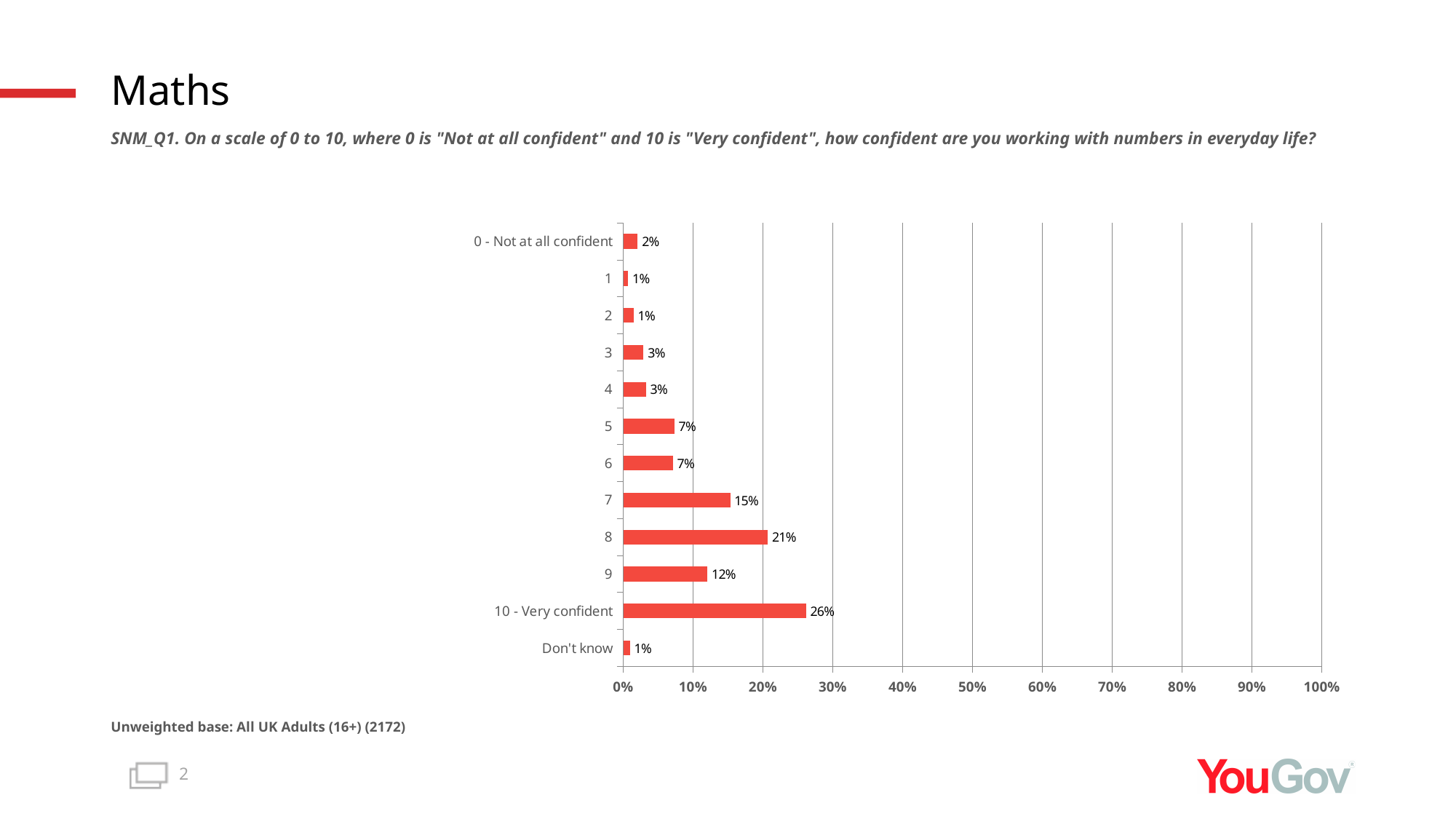
Which category has the highest percentage? 10 - Very confident Which is larger, the percentage for rating 7 or the percentage for rating 9? Rating 7 What percentage of respondents answered "Don't know"? 1% What percentage of respondents gave a rating of 8? 21% What percentage of respondents gave a rating of 7? 15% What kind of chart is shown on the slide? Bar chart What is the unweighted base stated on the slide? All UK Adults (16+) (2172) What is the combined percentage for ratings 9 and "10 - Very confident"? 38% Is the value for "10 - Very confident" greater or less than 20%? greater How many categories are shown on the chart? 12 What percentage of respondents rated their confidence as "10 - Very confident"? 26% What is the difference in percentage points between the rating of 8 and the rating of 9? 9